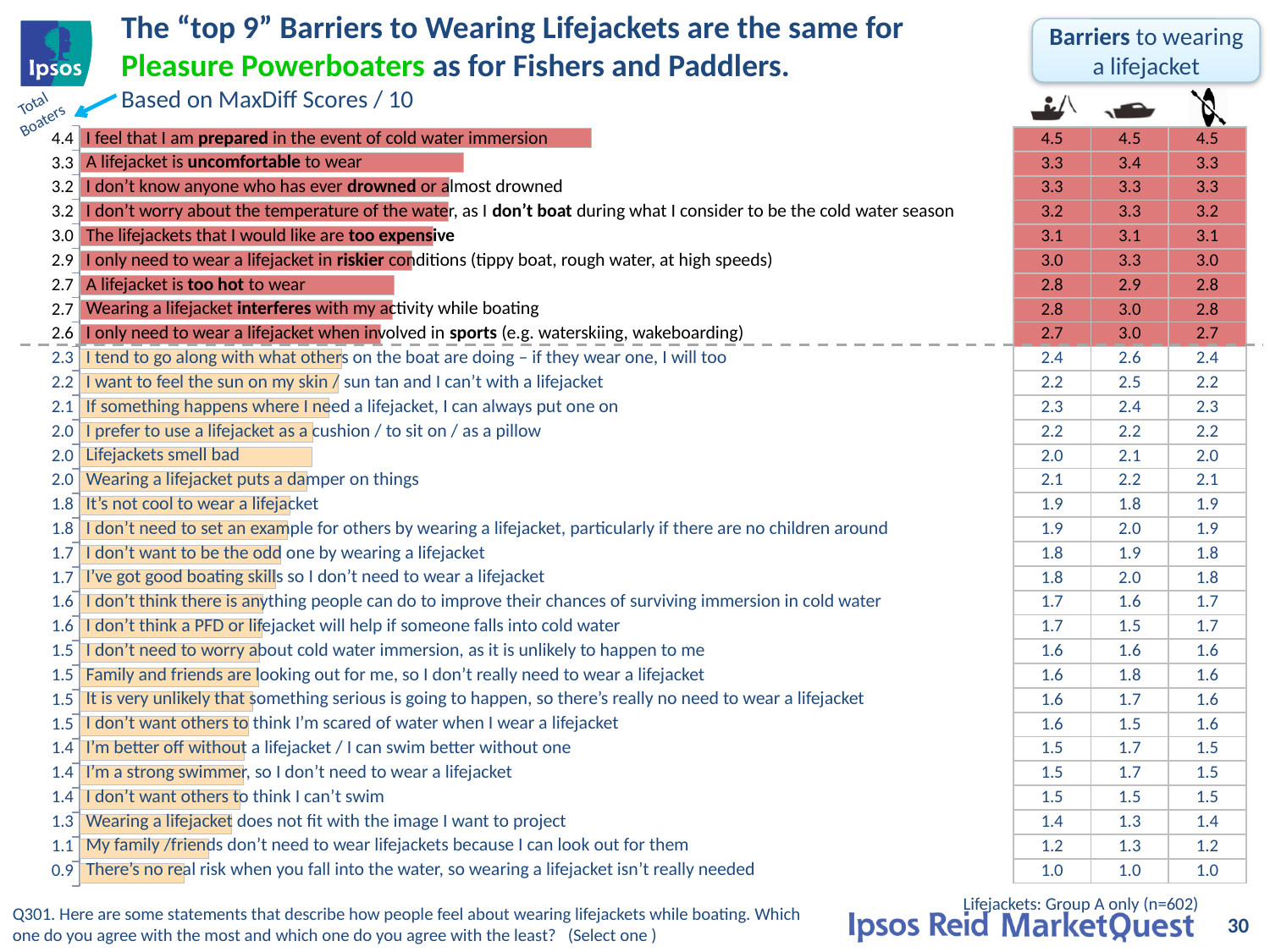
What is the Total Boaters MaxDiff score for "I feel that I am prepared in the event of cold water immersion"? 4.4 Which barrier has the lowest Total Boaters MaxDiff score? There's no real risk when you fall into the water, so wearing a lifejacket isn't really needed What kind of chart is used to show the Total Boaters MaxDiff scores? bar chart What is the Total Boaters MaxDiff score for "Lifejackets smell bad"? 2.0 How many bars are shaded red (the "top 9" barriers above the dashed line)? 9 What is the difference between the highest Total Boaters score (4.4) and the lowest (0.9)? 3.5 What is the Total Boaters MaxDiff score for "A lifejacket is too hot to wear"? 2.7 Which barrier has the highest Total Boaters MaxDiff score? I feel that I am prepared in the event of cold water immersion What is the difference between the Total Boaters scores for "A lifejacket is uncomfortable to wear" and "I only need to wear a lifejacket when involved in sports"? 0.7 Which has a higher Total Boaters score: "A lifejacket is uncomfortable to wear" or "A lifejacket is too hot to wear"? A lifejacket is uncomfortable to wear How many barrier statements are plotted as bars in the chart? 31 Do the Total Boaters scores increase or decrease going from the top bar to the bottom bar? decrease